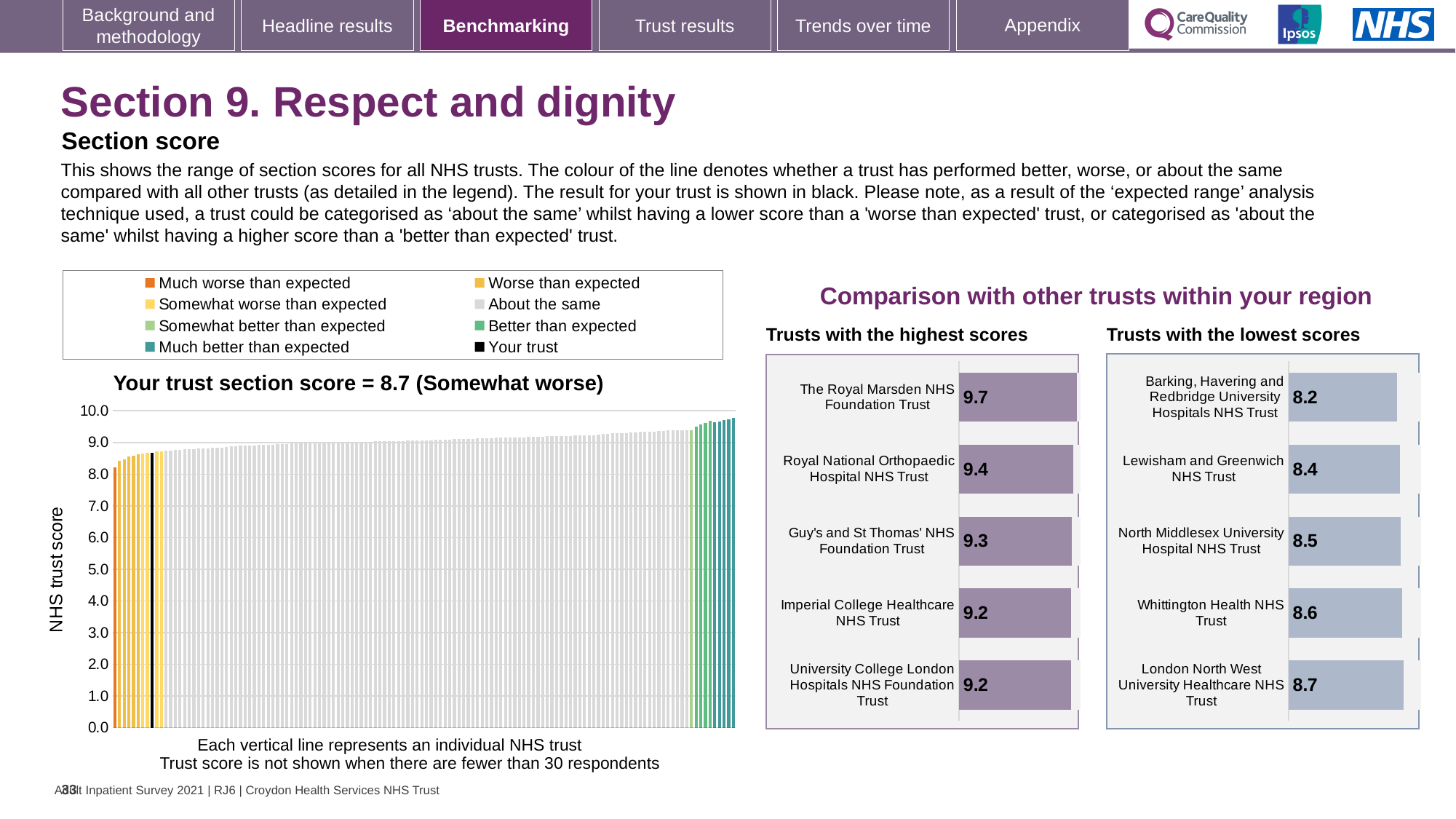
In the 'Your trust section score' chart, do the trust scores rise or fall from left to right? rise In the 'Your trust section score' chart, what is the section score for your trust? 8.7 How many entries does the legend above the 'Your trust section score' chart list? 8 In the 'Trusts with the highest scores' chart, which trust has the highest score? The Royal Marsden NHS Foundation Trust In the 'Trusts with the lowest scores' chart, what is the score for Lewisham and Greenwich NHS Trust? 8.4 In the 'Your trust section score' chart, how is your trust's score categorised? Somewhat worse In the 'Trusts with the lowest scores' chart, which has the larger score: North Middlesex University Hospital NHS Trust or London North West University Healthcare NHS Trust? London North West University Healthcare NHS Trust How many trusts are shown in the 'Trusts with the highest scores' chart? 5 What kind of chart is the 'Your trust section score' chart? bar chart In the 'Trusts with the lowest scores' chart, which trust has the lowest score? Barking, Havering and Redbridge University Hospitals NHS Trust In the 'Trusts with the highest scores' chart, what is the difference between the scores of The Royal Marsden NHS Foundation Trust and Imperial College Healthcare NHS Trust? 0.5 In the 'Trusts with the highest scores' chart, what is the score for The Royal Marsden NHS Foundation Trust? 9.7